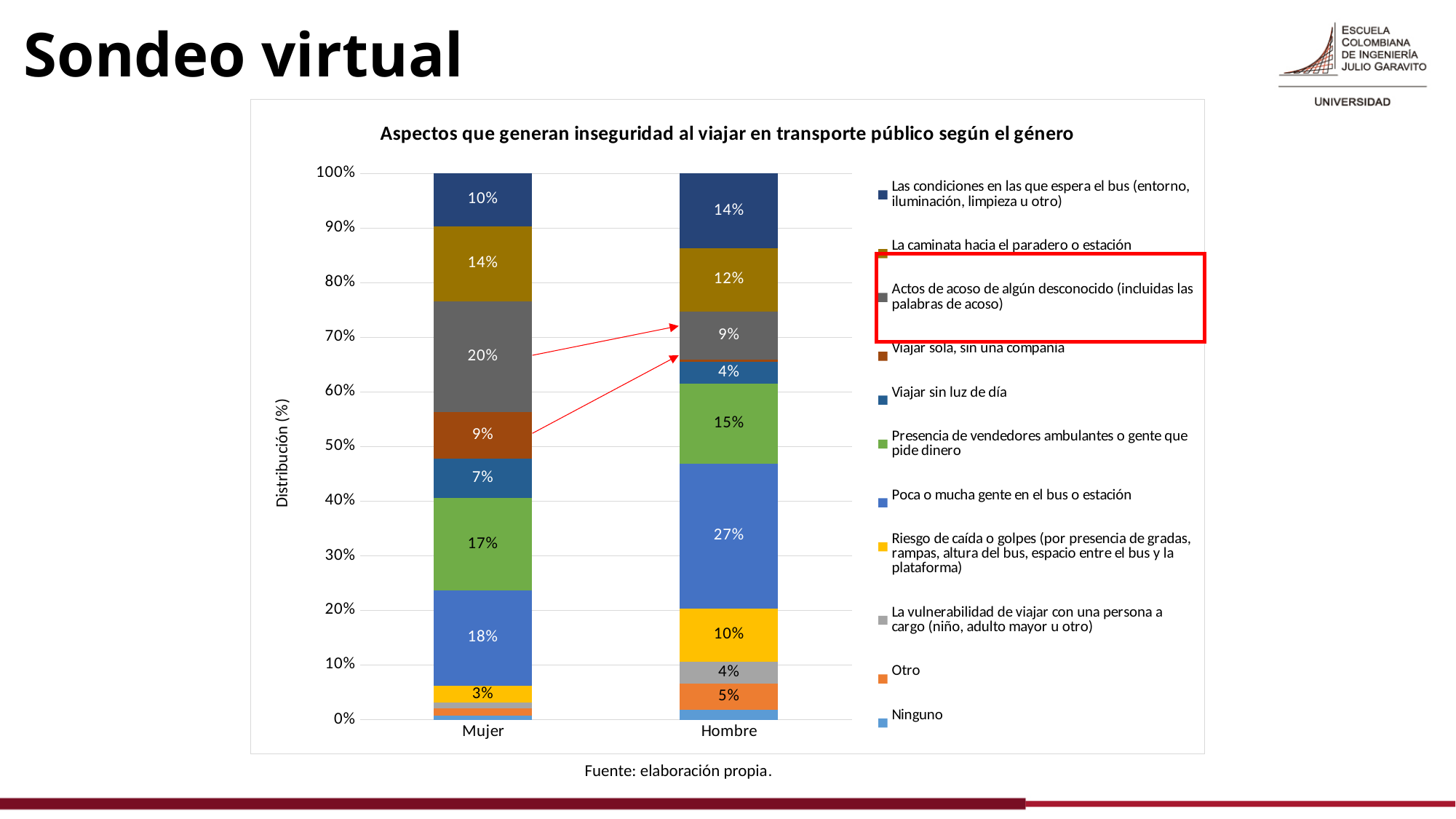
What is the title of the chart? Aspectos que generan inseguridad al viajar en transporte público según el género What is the value for 'Poca o mucha gente en el bus o estación' for Hombre? 27% What is the value for 'Riesgo de caída o golpes (por presencia de gradas, rampas, altura del bus, espacio entre el bus y la plataforma)' for Mujer? 3% What is the value for 'Presencia de vendedores ambulantes o gente que pide dinero' for Mujer? 17% What type of chart is shown on the slide? Stacked bar chart Which is larger for 'Poca o mucha gente en el bus o estación': the Mujer value or the Hombre value? Hombre What is the difference between the Mujer and Hombre values for 'Actos de acoso de algún desconocido (incluidas las palabras de acoso)'? 11% What is the value for 'Actos de acoso de algún desconocido (incluidas las palabras de acoso)' for Mujer? 20% What is the value for 'Actos de acoso de algún desconocido (incluidas las palabras de acoso)' for Hombre? 9% How many series does the legend list? 11 How many categories are shown on the x axis of the chart? 2 Which segment is the largest in the Hombre bar? Poca o mucha gente en el bus o estación